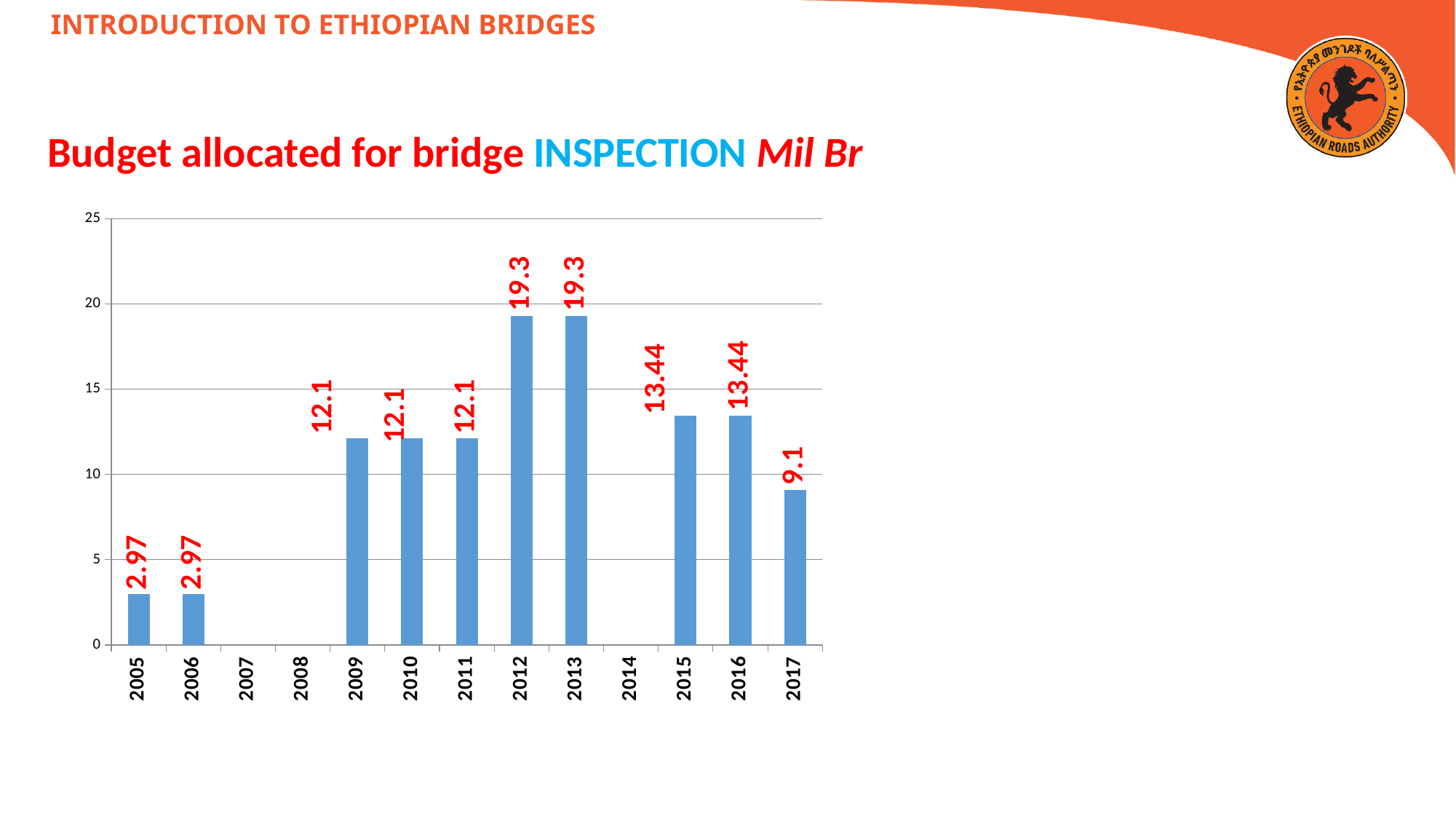
What is the difference between the values for 2012 and 2009? 7.2 How many years are labelled on the x axis? 13 What is the budget allocated for bridge inspection in 2012? 19.3 What value is shown for 2017? 9.1 What is the value for 2005? 2.97 What is the value shown for 2015? 13.44 Is the value for 2017 greater or less than 10? less Which year has the larger value, 2013 or 2016? 2013 What is the difference between the values for 2015 and 2017? 4.34 What is the lowest value plotted on the chart? 2.97 What kind of chart is shown on the slide? bar chart What is the highest value plotted on the chart? 19.3